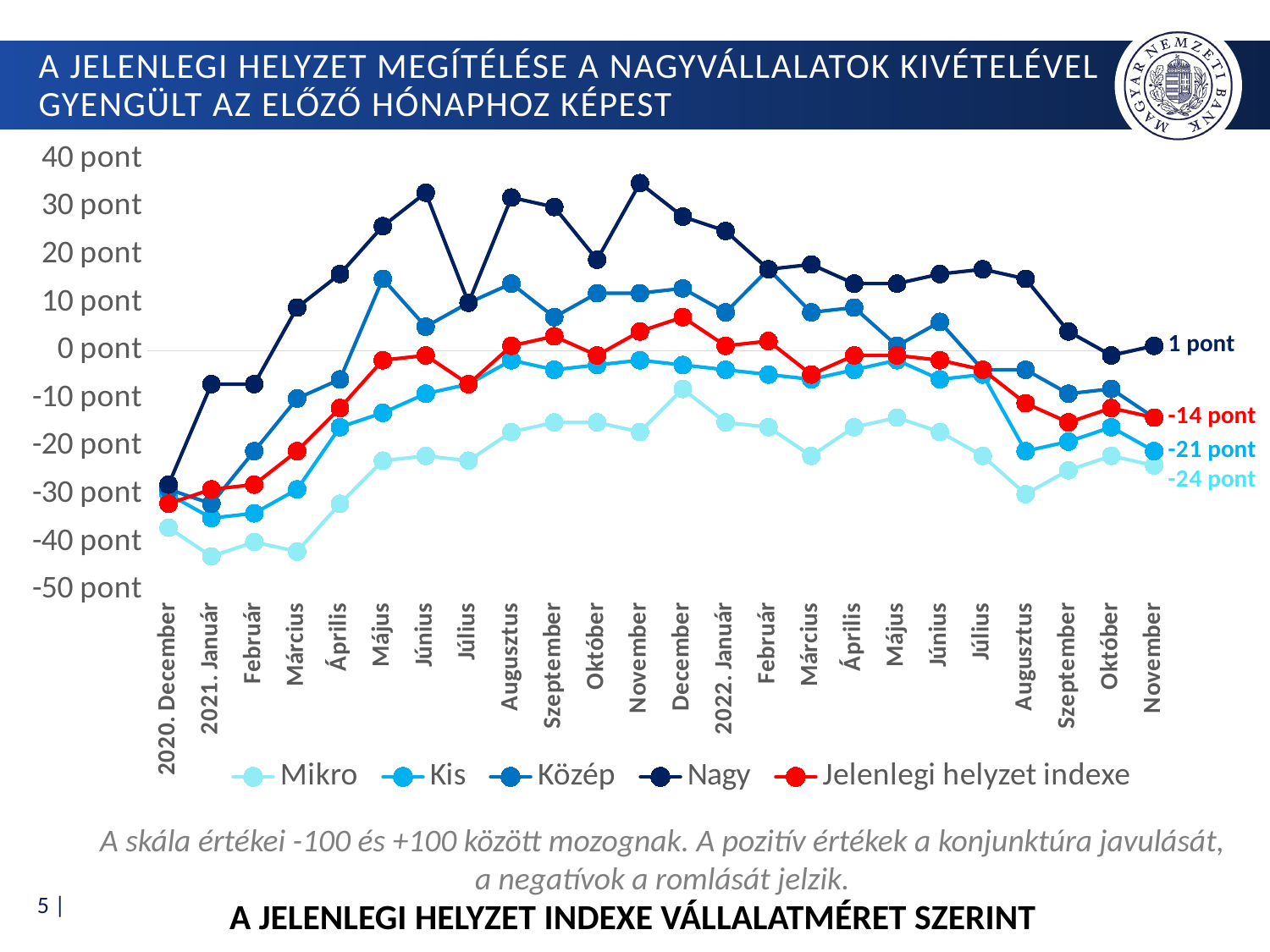
Which series has the highest value in 2022 November? Nagy Which series has the lowest value in 2022 November? Mikro What is the value of the Kis series in 2022 November? -21 pont In 2022 November, what is the difference between the Kis value and the Mikro value? 3 pont What is the value of the Nagy series in 2022 November? 1 pont How many series does the legend list? 5 What is the value of the Mikro series in 2022 November? -24 pont In 2022 November, how much higher is the Nagy value than the Jelenlegi helyzet indexe value? 15 pont How many months are shown on the x axis? 24 Is the value of the Nagy series in 2021 November greater or less than 30 pont? greater What is the value of the Jelenlegi helyzet indexe series in 2022 November? -14 pont What kind of chart is shown on the slide? Line chart